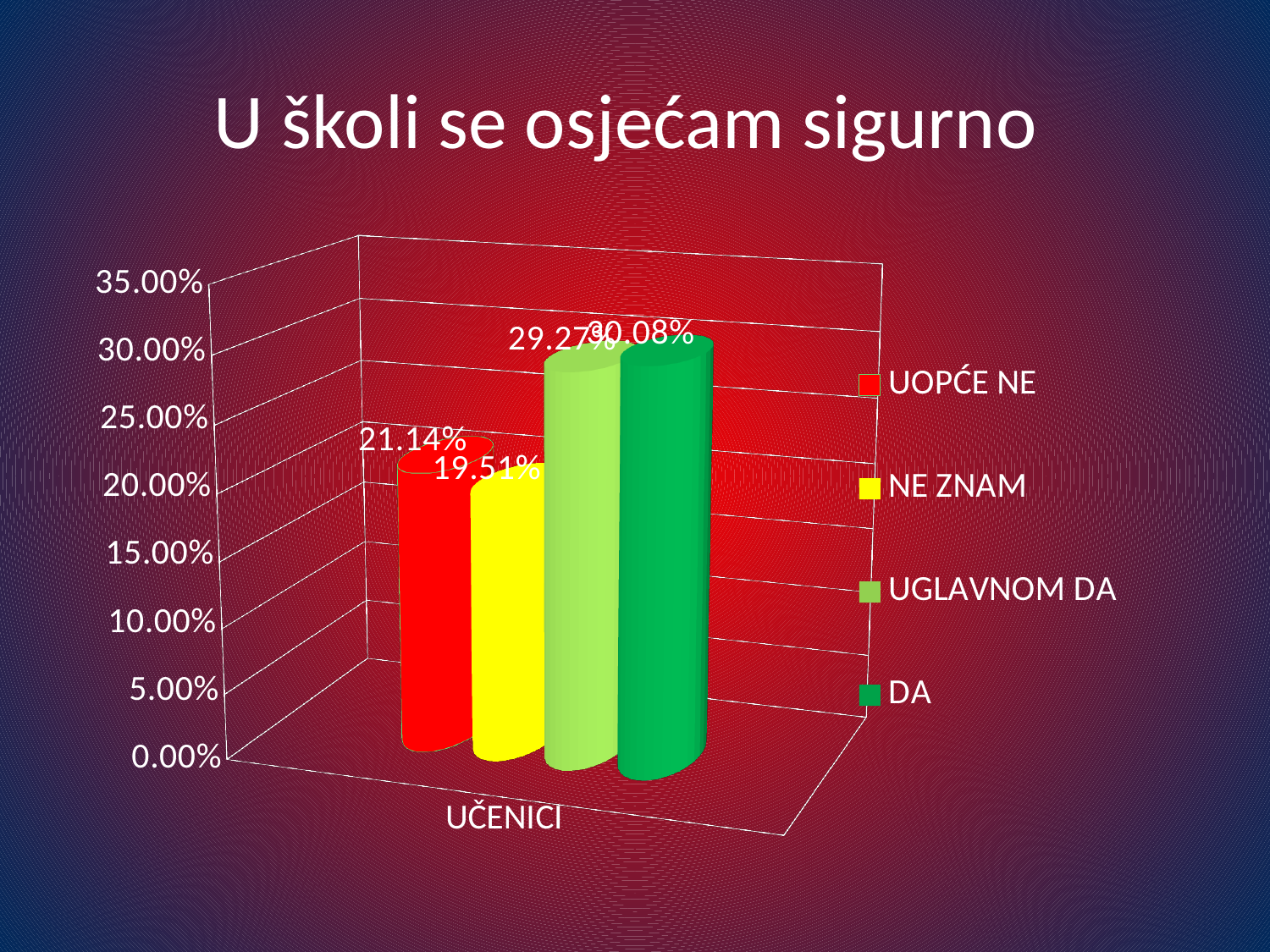
What is the value for DA? 30.08% What is the value for NE ZNAM? 19.51% What is the difference between the values for UOPĆE NE and NE ZNAM? 1.63% Is the value for NE ZNAM greater or less than 20.00%? less Which series has the lowest value? NE ZNAM What is the difference between the values for DA and UGLAVNOM DA? 0.81% How many series does the legend list? 4 What is the title of the chart? U školi se osjećam sigurno What is the value for UGLAVNOM DA? 29.27% Which is larger, the value for UOPĆE NE or the value for NE ZNAM? UOPĆE NE Which series has the highest value? DA What is the value for UOPĆE NE? 21.14%